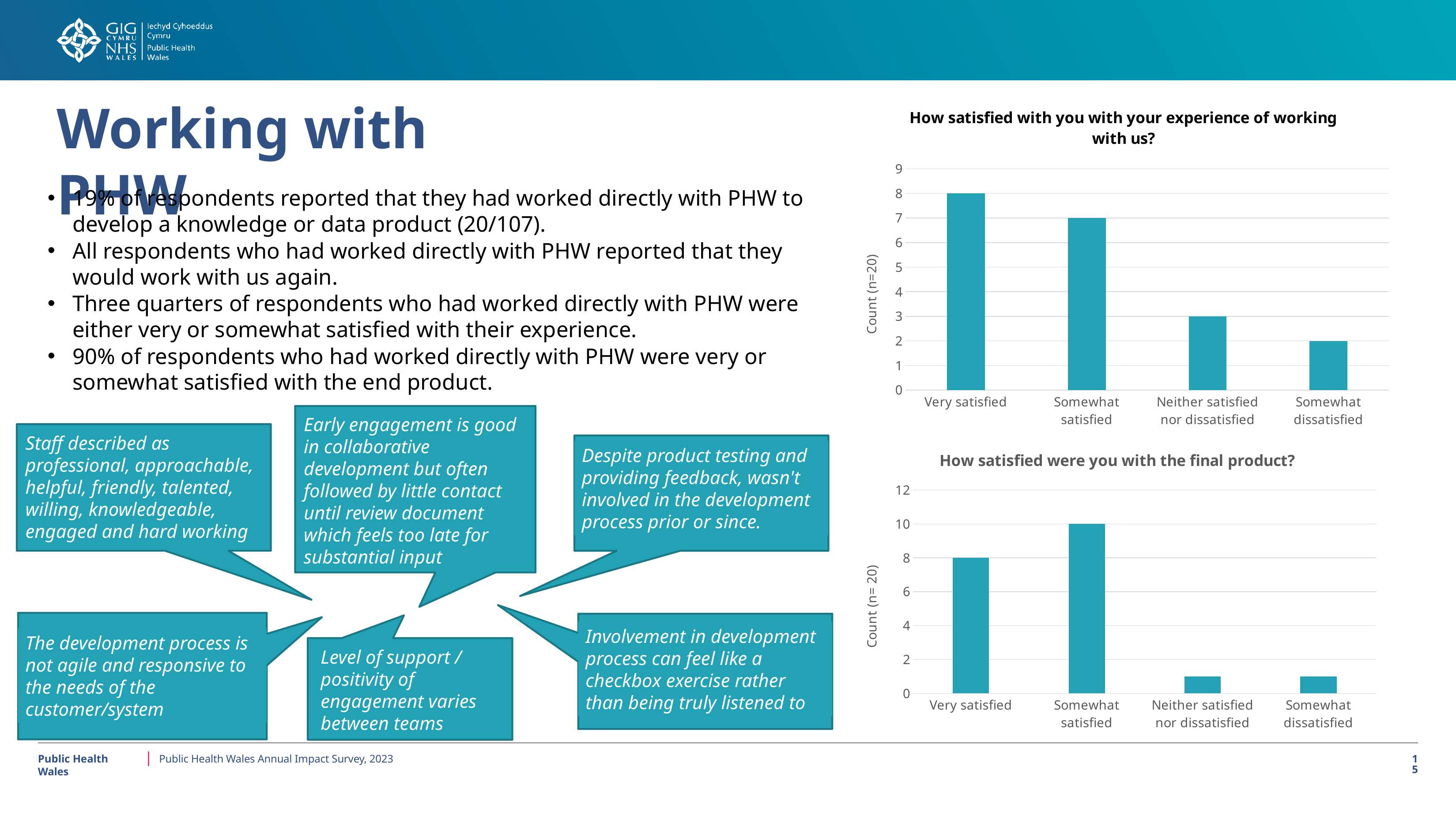
In the chart titled 'How satisfied with you with your experience of working with us?', what is the difference between the counts for Very satisfied and Somewhat dissatisfied? 6 In the chart titled 'How satisfied were you with the final product?', which is larger: the count for Very satisfied or the count for Somewhat satisfied? Somewhat satisfied In the chart titled 'How satisfied with you with your experience of working with us?', what is the count for Neither satisfied nor dissatisfied? 3 What type of chart is the chart titled 'How satisfied were you with the final product?'? Bar chart In the chart titled 'How satisfied were you with the final product?', which category has the highest count? Somewhat satisfied In the chart titled 'How satisfied were you with the final product?', is the count for Neither satisfied nor dissatisfied greater or less than 2? less In the chart titled 'How satisfied with you with your experience of working with us?', what is the count for Very satisfied? 8 In the chart titled 'How satisfied with you with your experience of working with us?', how many categories are shown on the x axis? 4 In the chart titled 'How satisfied were you with the final product?', what is the count for Somewhat satisfied? 10 In the chart titled 'How satisfied were you with the final product?', what is the count for Very satisfied? 8 In the chart titled 'How satisfied with you with your experience of working with us?', which category has the lowest count? Somewhat dissatisfied In the chart titled 'How satisfied with you with your experience of working with us?', what is the count for Somewhat satisfied? 7